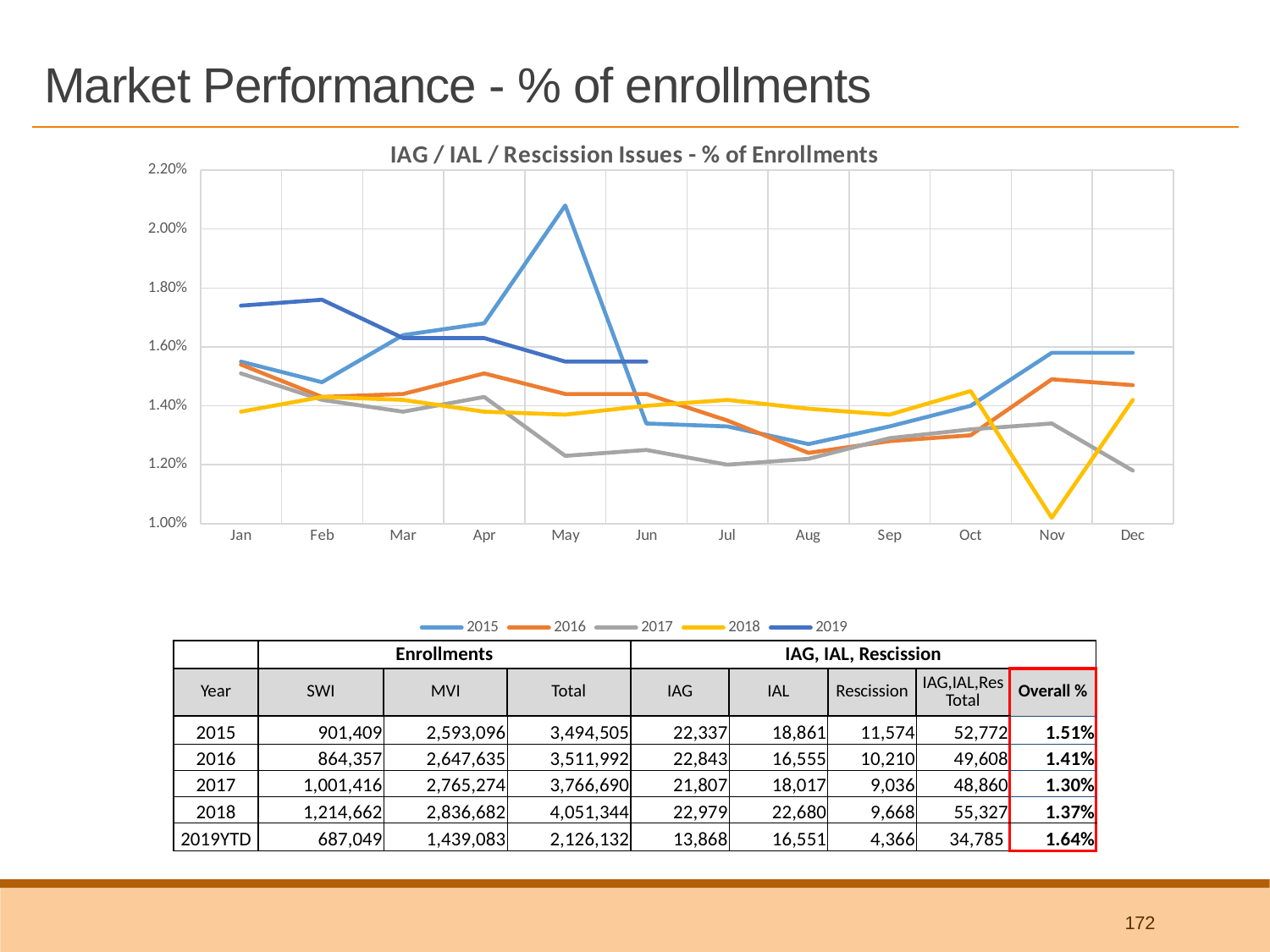
How many months are shown along the x axis of the chart? 12 In which month does the 2015 series reach its highest value? May Is the value for 2019 in Jan greater or less than 1.60%? greater Does the 2019 series rise or fall overall from Jan to Jun? fall Which is larger in Jan, the value for 2019 or the value for 2015? 2019 Is the value for 2015 in May greater or less than 2.00%? greater How many series does the chart legend list? 5 In which month does the 2018 series reach its lowest value? Nov Which series has the highest value in Jan? 2019 What kind of chart is shown on the slide? line chart Is the value for 2018 in Nov greater or less than 1.20%? less What is the title of the chart? IAG / IAL / Rescission Issues - % of Enrollments